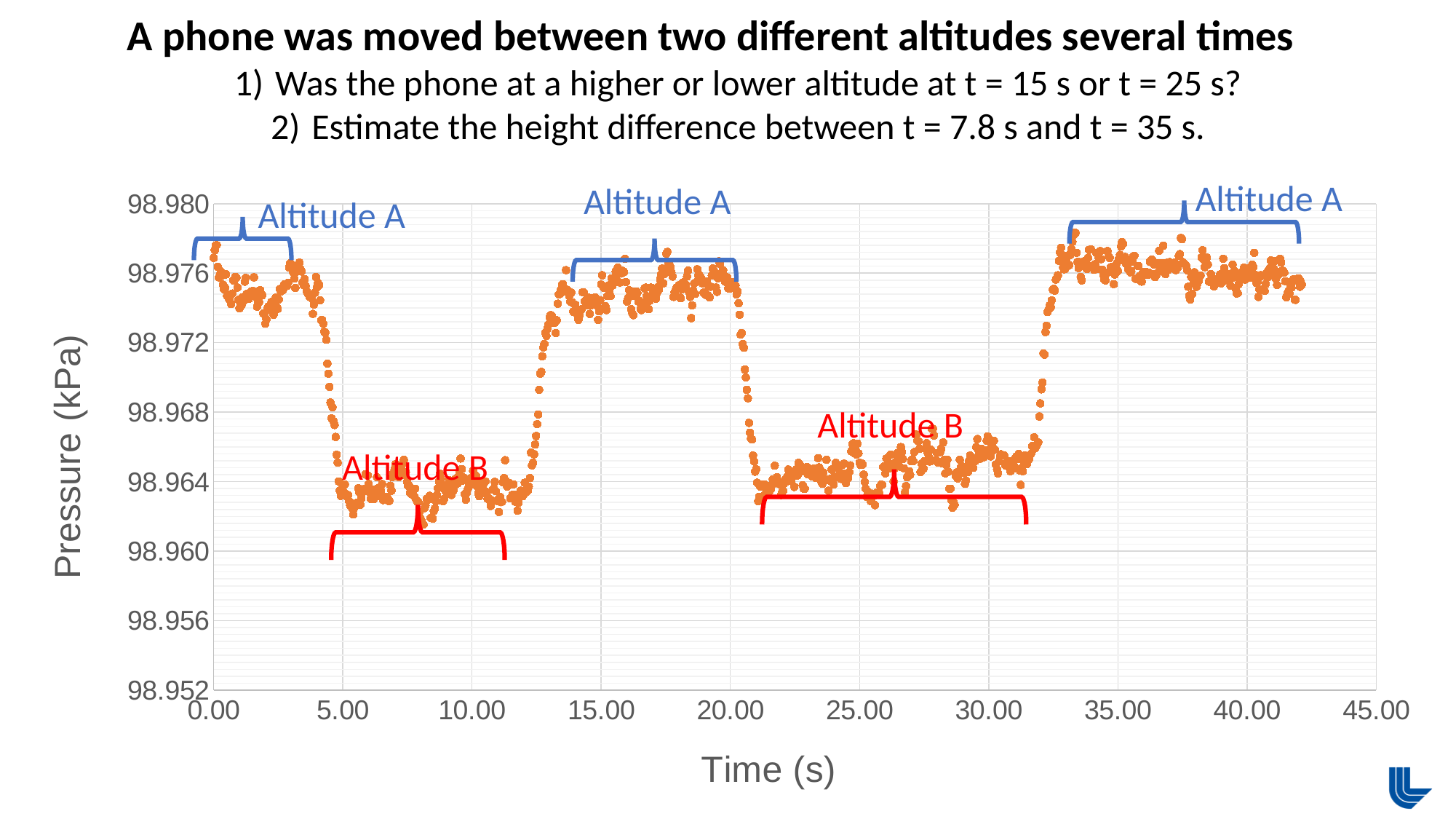
Between t = 4 s and t = 5 s, does the pressure rise or fall? fall What kind of chart is shown on the slide? scatter plot Between t = 31 s and t = 33 s, does the pressure rise or fall? rise Is the pressure higher at t = 7.8 s or at t = 35 s? t = 35 s What is the label of the horizontal axis? Time (s) What is the label of the vertical axis? Pressure (kPa) Is the pressure at t = 25 s greater or less than 98.968 kPa? less Between t = 20 s and t = 22 s, does the pressure rise or fall? fall Is the pressure at t = 40 s greater or less than 98.972 kPa? greater Is the pressure at t = 7.8 s greater or less than 98.968 kPa? less Is the pressure higher at t = 15 s or at t = 25 s? t = 15 s